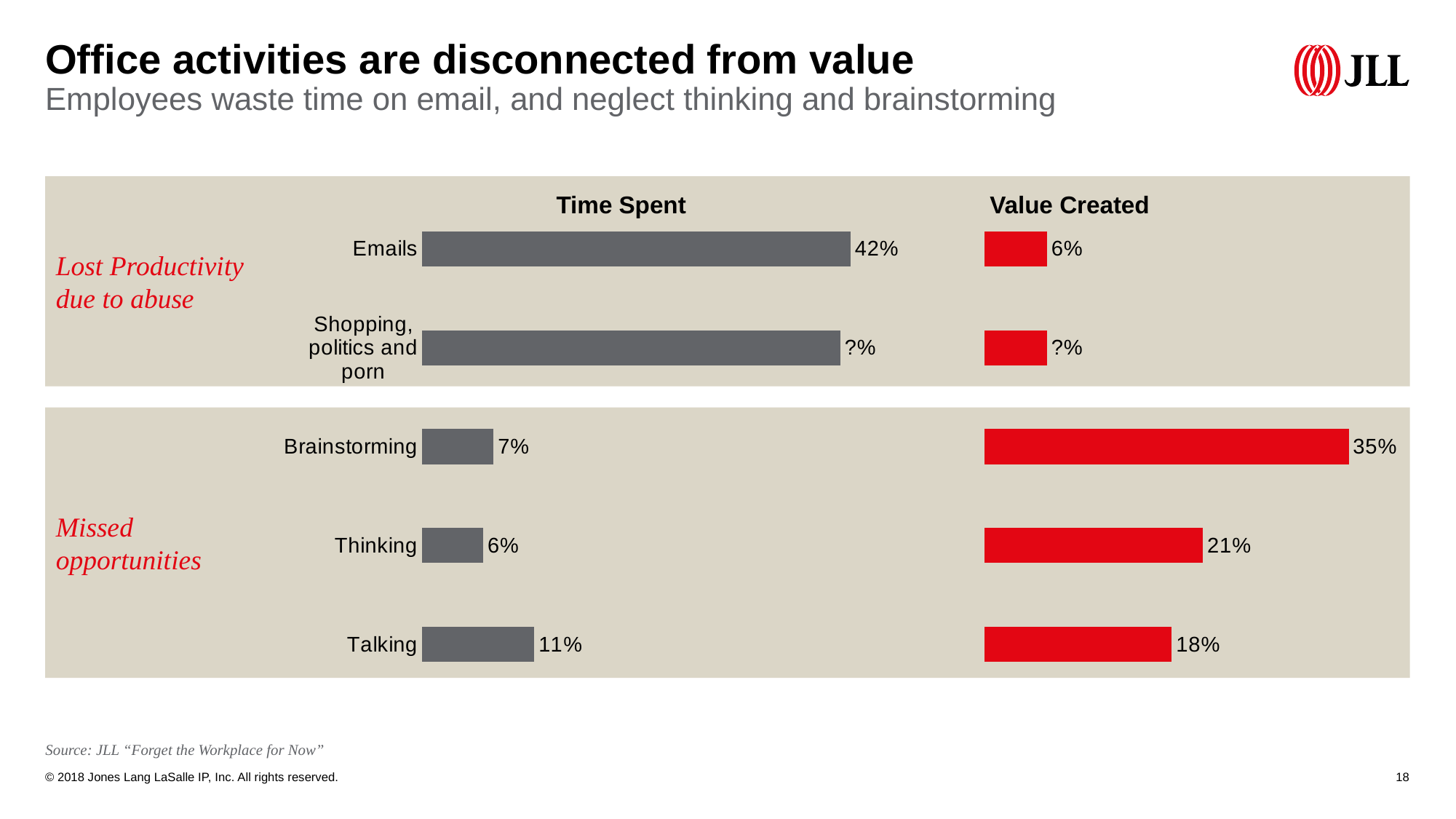
In the Time Spent chart, what is the value for Emails? 42% What is the difference between the Time Spent value for Emails and the Value Created value for Emails? 36% What kind of chart is used on this slide? Bar chart In the Value Created chart, what is the value for Thinking? 21% In the Time Spent chart, which activity has the highest value? Emails In the Value Created chart, which activity has the lowest labelled value? Emails In the Value Created chart, what is the value for Emails? 6% In the Value Created chart, what is the difference between Brainstorming and Talking? 17% In the Time Spent chart, which is larger: Talking or Thinking? Talking In the Value Created chart, what is the value for Brainstorming? 35% What colour are the bars in the Value Created chart? Red In the Time Spent chart, what is the value for Talking? 11%